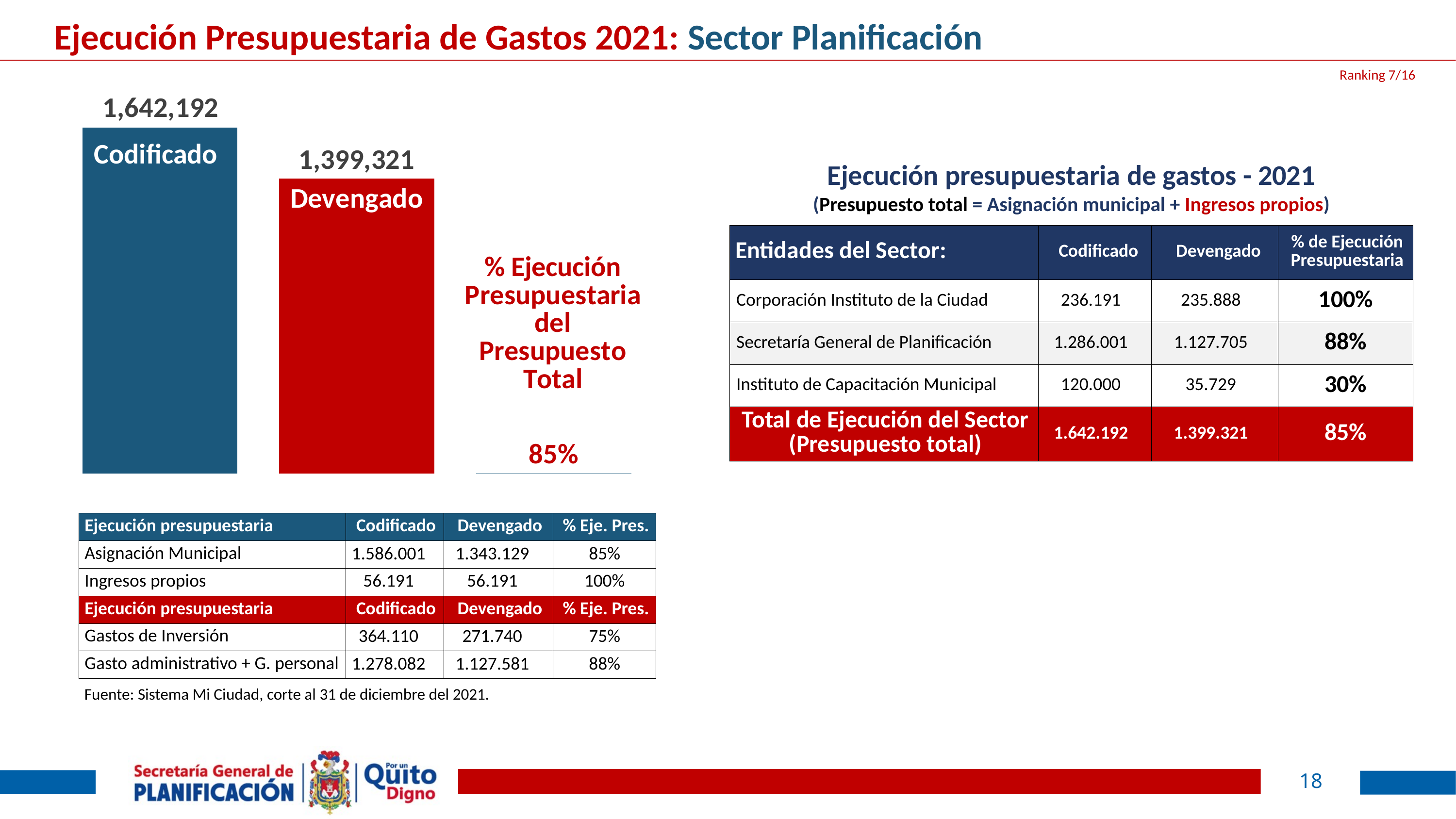
What is the value of the Codificado bar in the bar chart? 1,642,192 What colour is the Devengado bar in the chart? Red What percentage is shown next to the bar chart as the % Ejecución Presupuestaria del Presupuesto Total? 85% How many bars are shown in the bar chart? 2 Which is larger in the bar chart, Codificado or Devengado? Codificado What type of chart is shown on the left of the slide? Bar chart Which bar in the chart is the tallest? Codificado Do the values fall or rise from the Codificado bar to the Devengado bar? Fall What colour is the Codificado bar in the chart? Blue Which bar in the chart is the shortest? Devengado What is the difference between the Codificado and Devengado values in the bar chart? 242,871 What is the value of the Devengado bar in the bar chart? 1,399,321